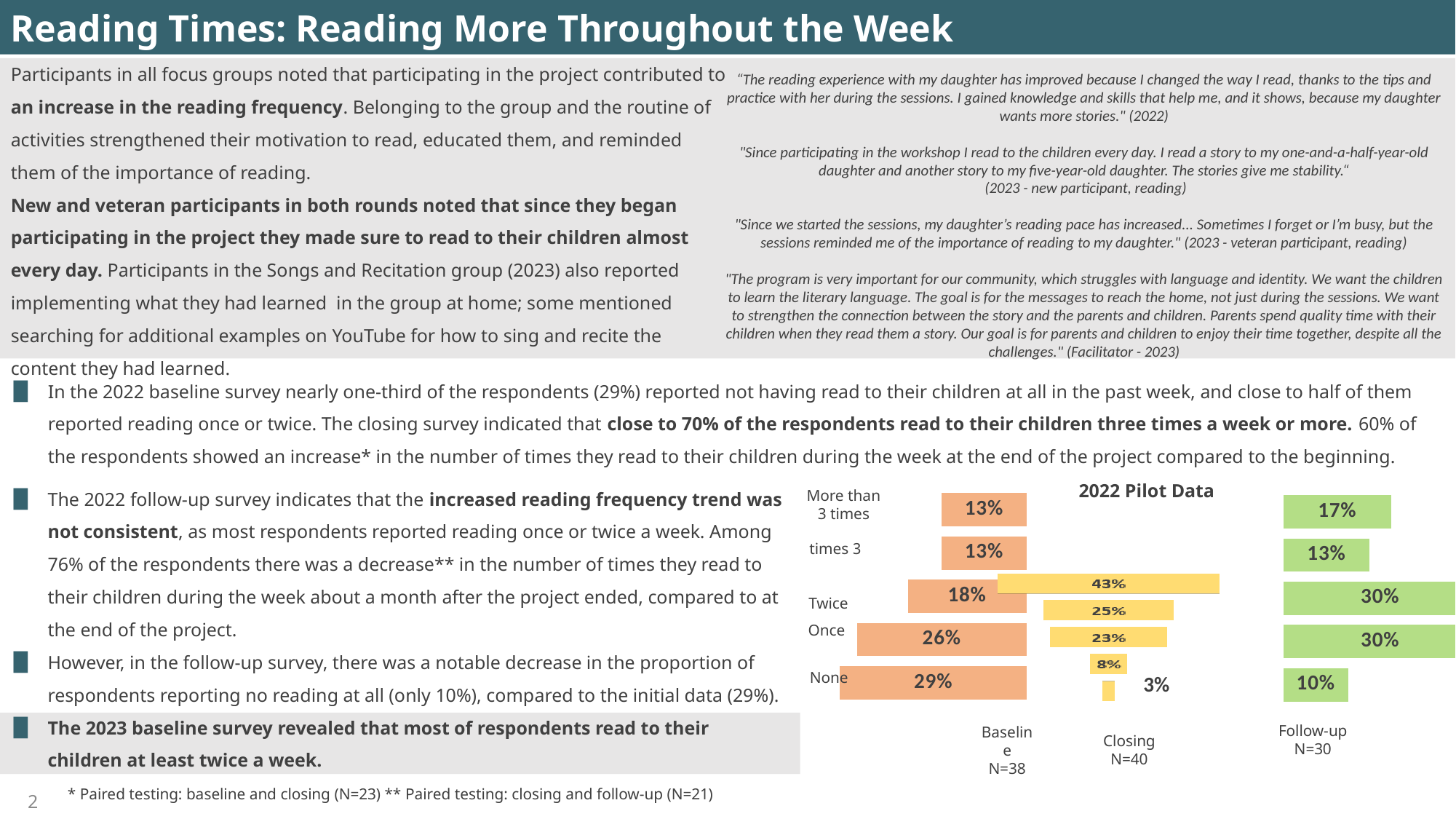
In the 2022 Pilot Data chart, which category has the lowest Follow-up value? None What is the title of the chart on the slide? 2022 Pilot Data What kind of chart is the 2022 Pilot Data chart? bar chart In the 2022 Pilot Data chart, which is larger: the Baseline value for 'Twice' or the Follow-up value for 'Twice'? Follow-up (30%) How many reading-frequency categories are shown in the 2022 Pilot Data chart? 5 In the 2022 Pilot Data chart, which category has the highest Baseline value? None How many survey groups (series) are shown in the 2022 Pilot Data chart? 3 In the 2022 Pilot Data chart, what is the Baseline value for 'Once'? 26% In the 2022 Pilot Data chart, what is the Baseline value for 'None'? 29% In the 2022 Pilot Data chart, what is the difference between the Baseline and Follow-up values for 'None'? 19% In the 2022 Pilot Data chart, what is the Follow-up value for 'None'? 10% In the 2022 Pilot Data chart, what is the Follow-up value for 'More than 3 times'? 17%